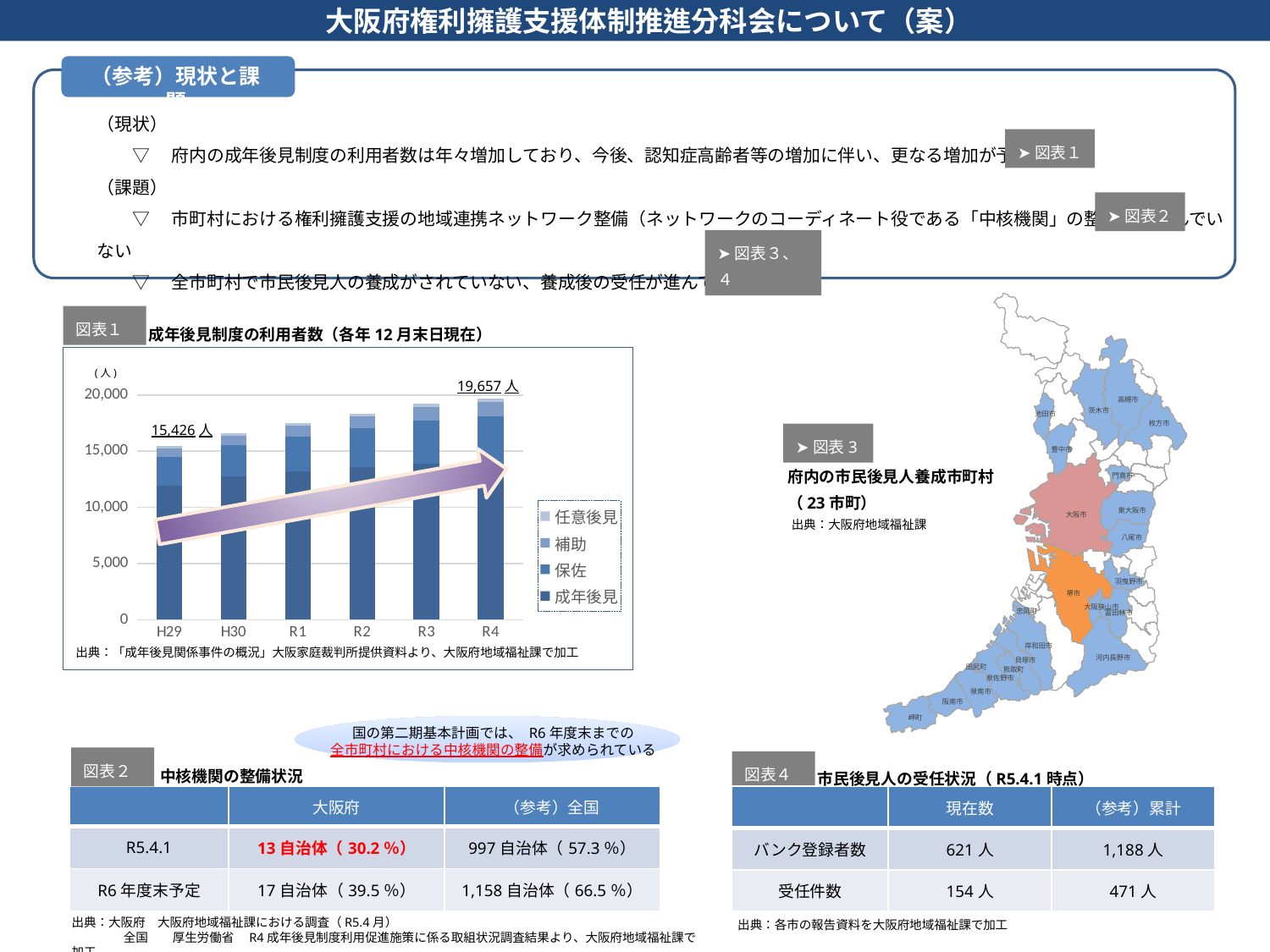
Is the total value for R3 in the 成年後見制度の利用者数 chart greater or less than 20,000? less Which year has the highest total in the 成年後見制度の利用者数 chart? R4 Do the total values in the 成年後見制度の利用者数 chart rise or fall from H29 to R4? rise Which series is listed last in the legend of the 成年後見制度の利用者数 chart? 成年後見 Is the total value for R2 in the 成年後見制度の利用者数 chart greater or less than 15,000? greater What is the total number of users shown for R4 in the 成年後見制度の利用者数 chart? 19,657 人 What is the difference between the R4 total and the H29 total in the 成年後見制度の利用者数 chart? 4,231 人 What kind of chart is the 成年後見制度の利用者数 chart? bar chart How many years (categories) are shown on the x axis of the 成年後見制度の利用者数 chart? 6 How many series does the legend of the 成年後見制度の利用者数 chart list? 4 What is the total number of users shown for H29 in the 成年後見制度の利用者数 chart? 15,426 人 Which year has the lowest total in the 成年後見制度の利用者数 chart? H29